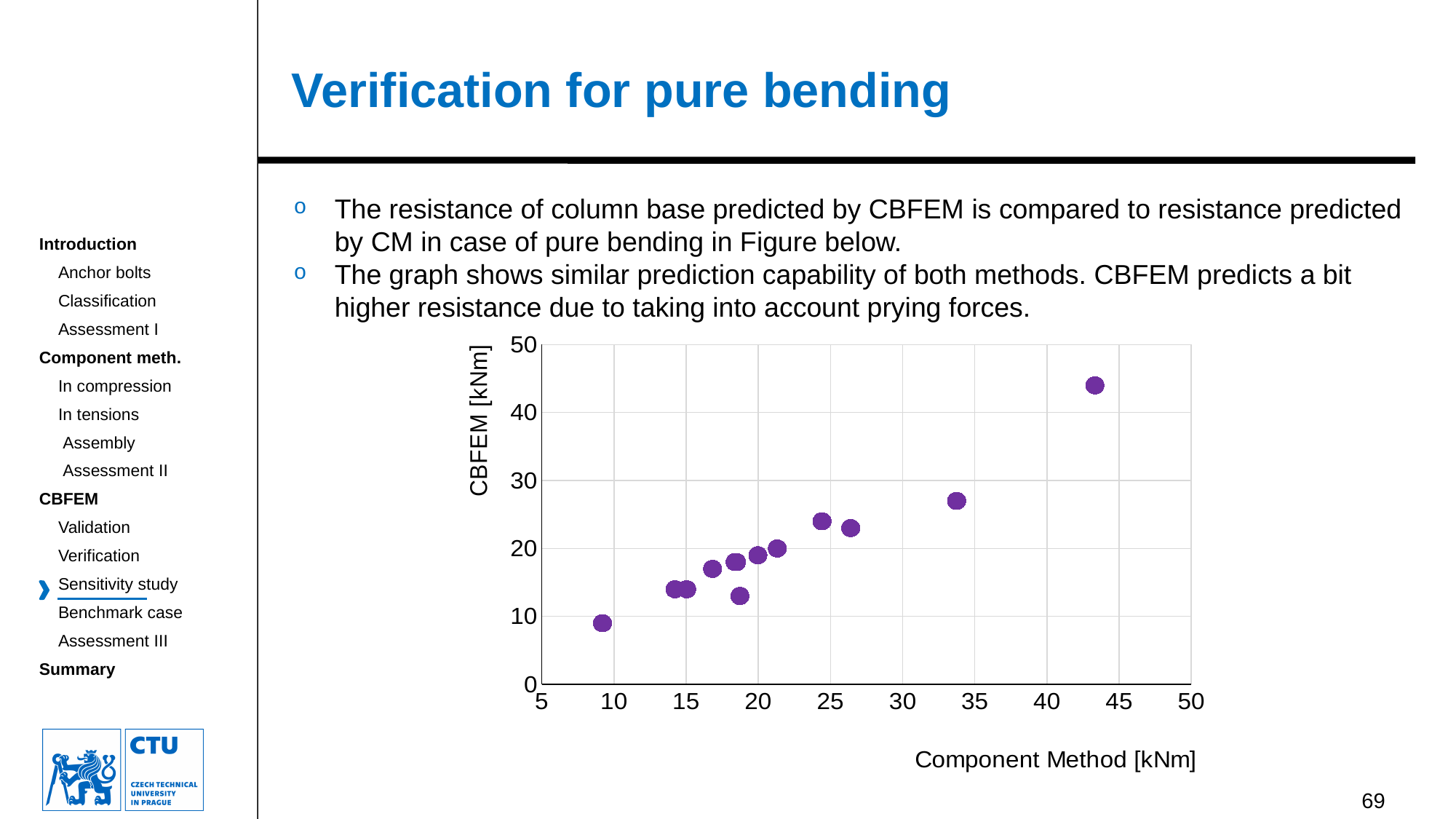
What is the maximum value shown on the vertical axis of the chart? 50 Is the CBFEM value of the rightmost point (Component Method around 43 kNm) greater or less than 40? greater Is the CBFEM value of the leftmost point (Component Method around 9 kNm) greater or less than 10? less Is the CBFEM value of the point at Component Method around 24 kNm greater or less than 20? greater Which point has the higher CBFEM value: the one at Component Method around 34 kNm or the one at around 43 kNm? the one at around 43 kNm What kind of chart is shown on the slide? scatter chart What is the label of the vertical axis of the chart? CBFEM [kNm] How many points have a CBFEM value greater than 30? 1 Do the CBFEM values generally rise or fall as the Component Method values increase along the x axis? rise What is the label of the horizontal axis of the chart? Component Method [kNm]